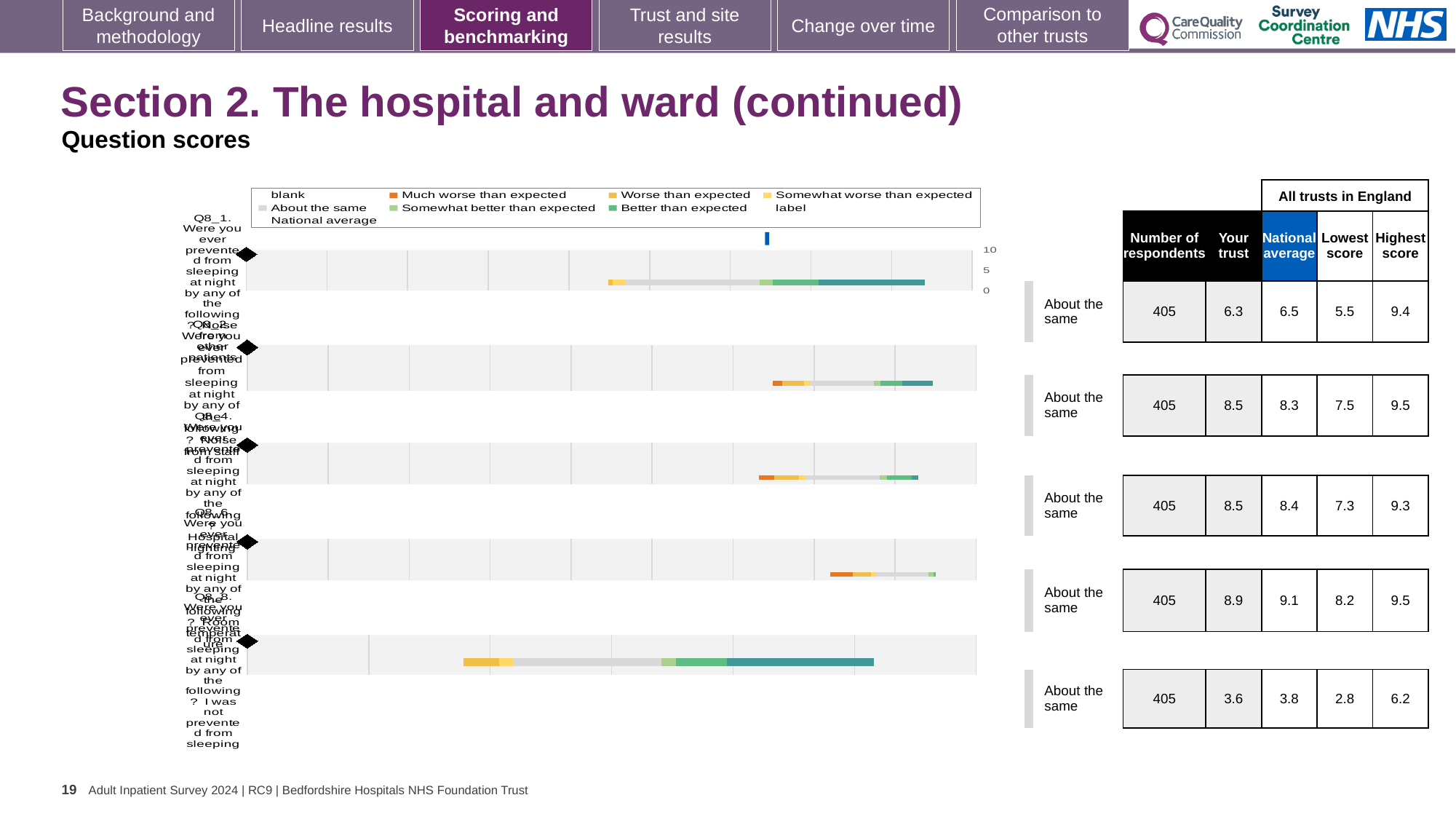
What is the 'Your trust' score for the first (top) row of the chart? 6.3 Which legend entry is shown in orange? Much worse than expected What is the national average for the fifth (bottom) row of the chart? 3.8 How many entries does the chart legend list? 9 What benchmark category is shown next to every row of the chart? About the same What is the number of respondents for the third row of the chart? 405 What kind of chart is shown on the slide? bar chart Which row has the highest 'Your trust' score? the fourth row (8.9) Which row has the lowest 'Your trust' score? the fifth row (3.6) For the first row, what is the difference between the national average (6.5) and the 'Your trust' score (6.3)? 0.2 How many question rows (bars) are plotted in the chart? 5 For the second row, which is larger: the 'Your trust' score or the national average? Your trust (8.5)